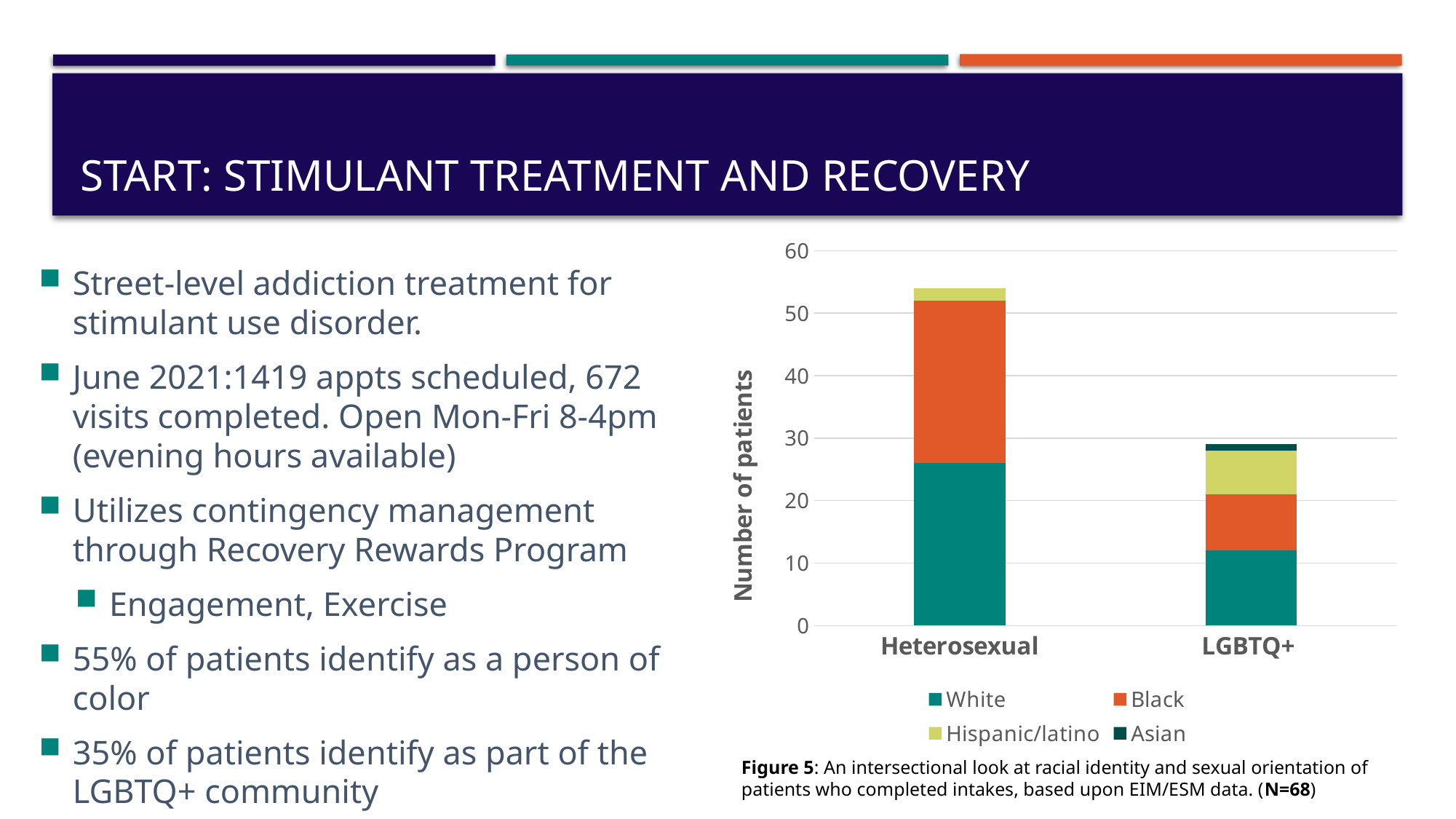
Is the total height of the LGBTQ+ bar greater or less than 20? greater What is the label of the chart's vertical axis? Number of patients What kind of chart is shown on the slide? Stacked bar chart Is the total height of the Heterosexual bar greater or less than 50? greater Which category has the taller stacked bar, Heterosexual or LGBTQ+? Heterosexual How many series does the chart's legend list? 4 Which series is shown in orange in the chart's legend? Black Is the White segment of the Heterosexual bar greater or less than 20? greater How many categories are shown on the x axis of the chart? 2 Which category has the larger Hispanic/latino segment, Heterosexual or LGBTQ+? LGBTQ+ Which category has the larger White segment, Heterosexual or LGBTQ+? Heterosexual